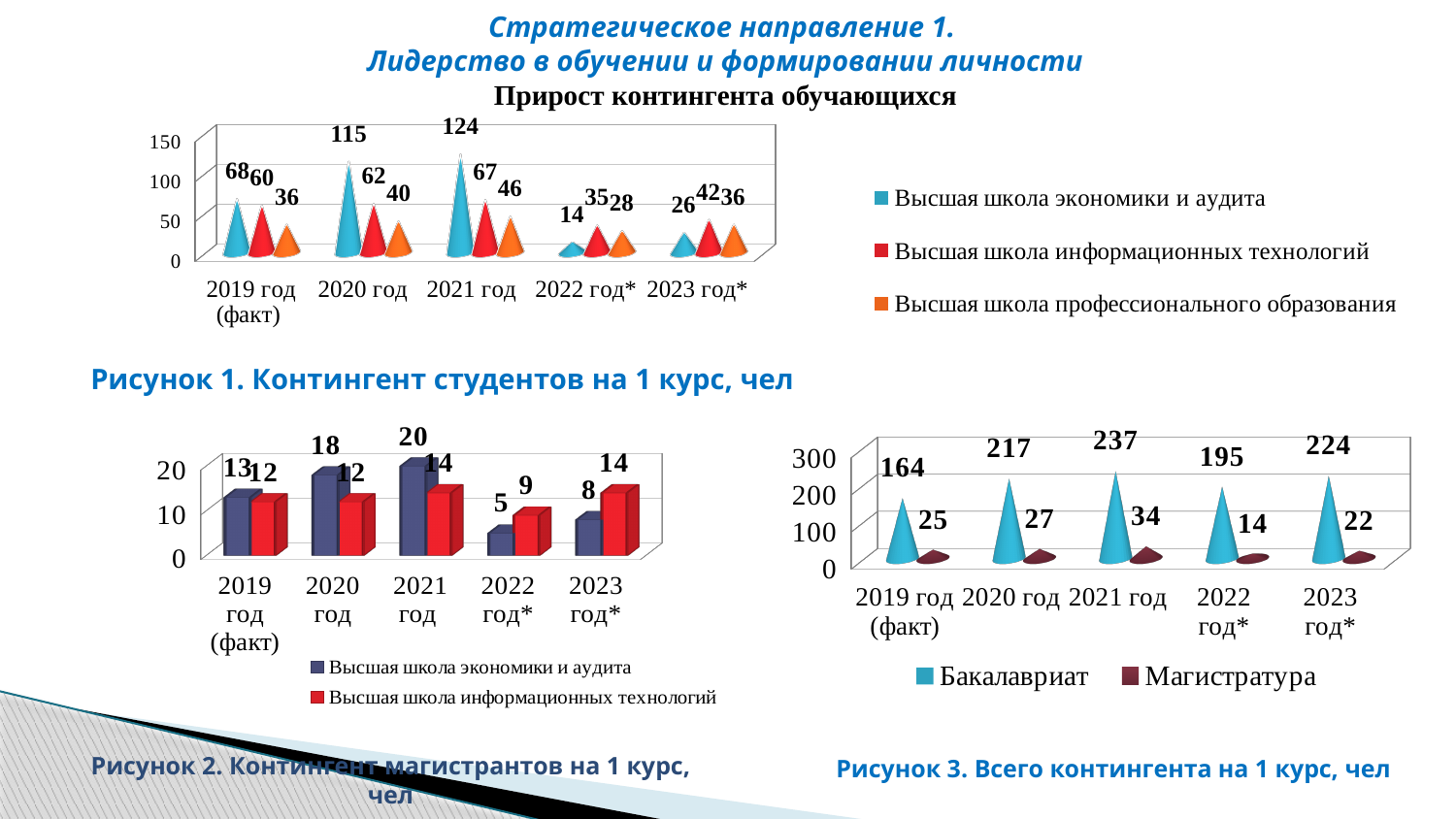
In the chart 'Рисунок 3. Всего контингента на 1 курс, чел', what is the value for Магистратура in 2021 год? 34 In the chart 'Рисунок 1. Контингент студентов на 1 курс, чел', which year has the lowest value for Высшая школа экономики и аудита? 2022 год* In the chart 'Рисунок 3. Всего контингента на 1 курс, чел', what is the difference between Бакалавриат and Магистратура in 2019 год (факт)? 139 In the chart 'Рисунок 3. Всего контингента на 1 курс, чел', does the value for Бакалавриат rise or fall from 2019 год (факт) to 2021 год? Rise In the chart 'Рисунок 1. Контингент студентов на 1 курс, чел', what is the value for Высшая школа экономики и аудита in 2021 год? 124 In the chart 'Рисунок 1. Контингент студентов на 1 курс, чел', which is larger in 2023 год*: Высшая школа информационных технологий or Высшая школа профессионального образования? Высшая школа информационных технологий How many year categories are shown on the x axis of the chart 'Рисунок 2. Контингент магистрантов на 1 курс, чел'? 5 What type of chart is 'Рисунок 2. Контингент магистрантов на 1 курс, чел'? Bar chart In the chart 'Рисунок 2. Контингент магистрантов на 1 курс, чел', which year has the highest value for Высшая школа экономики и аудита? 2021 год In the chart 'Рисунок 2. Контингент магистрантов на 1 курс, чел', what is the value for Высшая школа информационных технологий in 2022 год*? 9 How many series does the legend of the chart 'Рисунок 1. Контингент студентов на 1 курс, чел' list? 3 In the chart 'Рисунок 1. Контингент студентов на 1 курс, чел', what is the difference between Высшая школа экономики и аудита and Высшая школа профессионального образования in 2020 год? 75